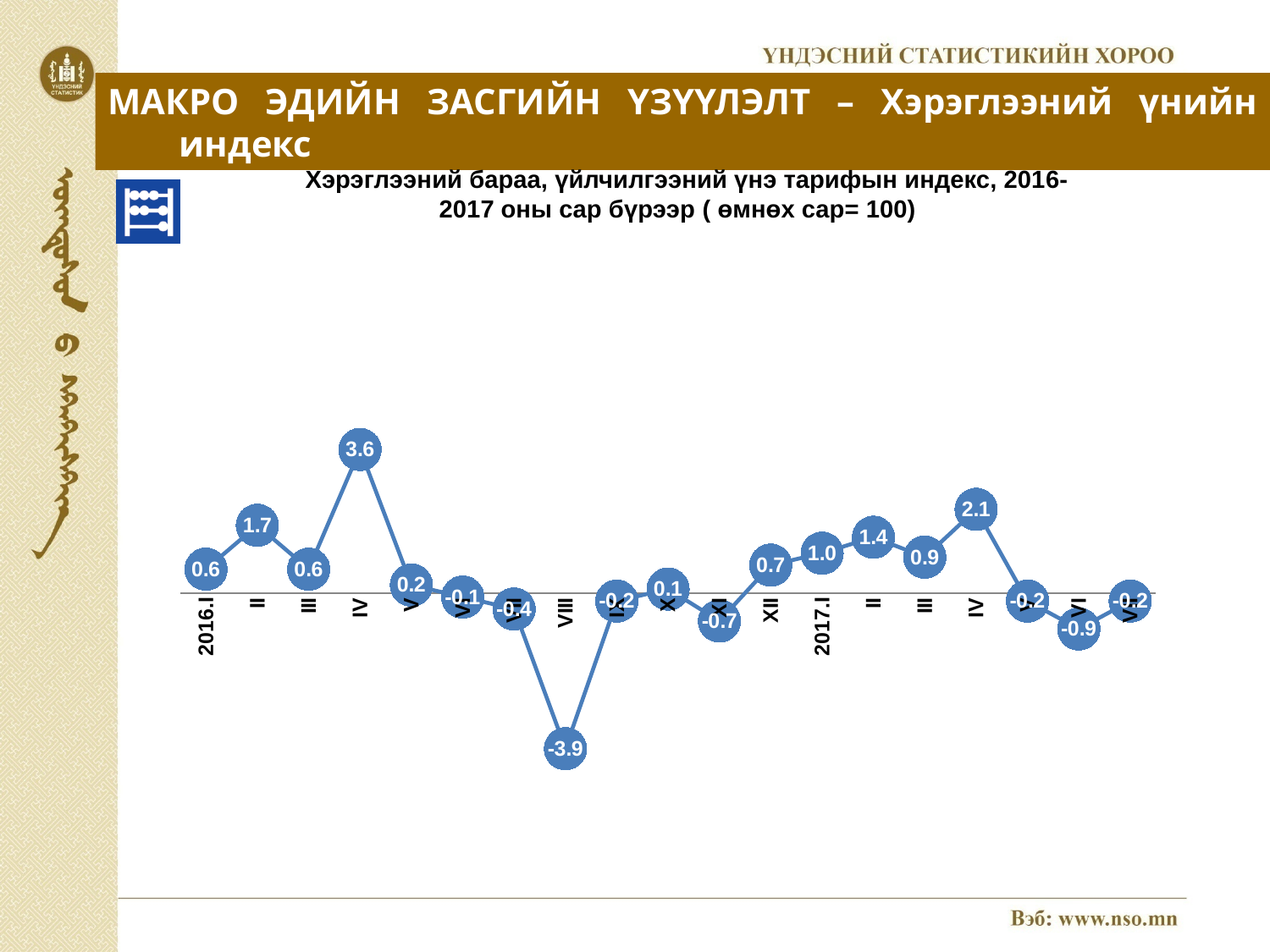
Which month has the highest value? 2016.IV What is the difference between the values for 2016.IV and 2017.IV? 1.5 What is the value for 2016.II? 1.7 Which month has the lowest value? 2016.VIII What is the value for 2017.VI? -0.9 What is the value for 2016.IV? 3.6 Which is larger, the value for 2017.II or the value for 2017.III? 2017.II What is the value for 2017.IV? 2.1 What is the value for 2016.VIII? -3.9 Does the value rise or fall from 2016.XI to 2017.II? rise How many data points are plotted on the chart? 19 What type of chart is shown on the slide? line chart